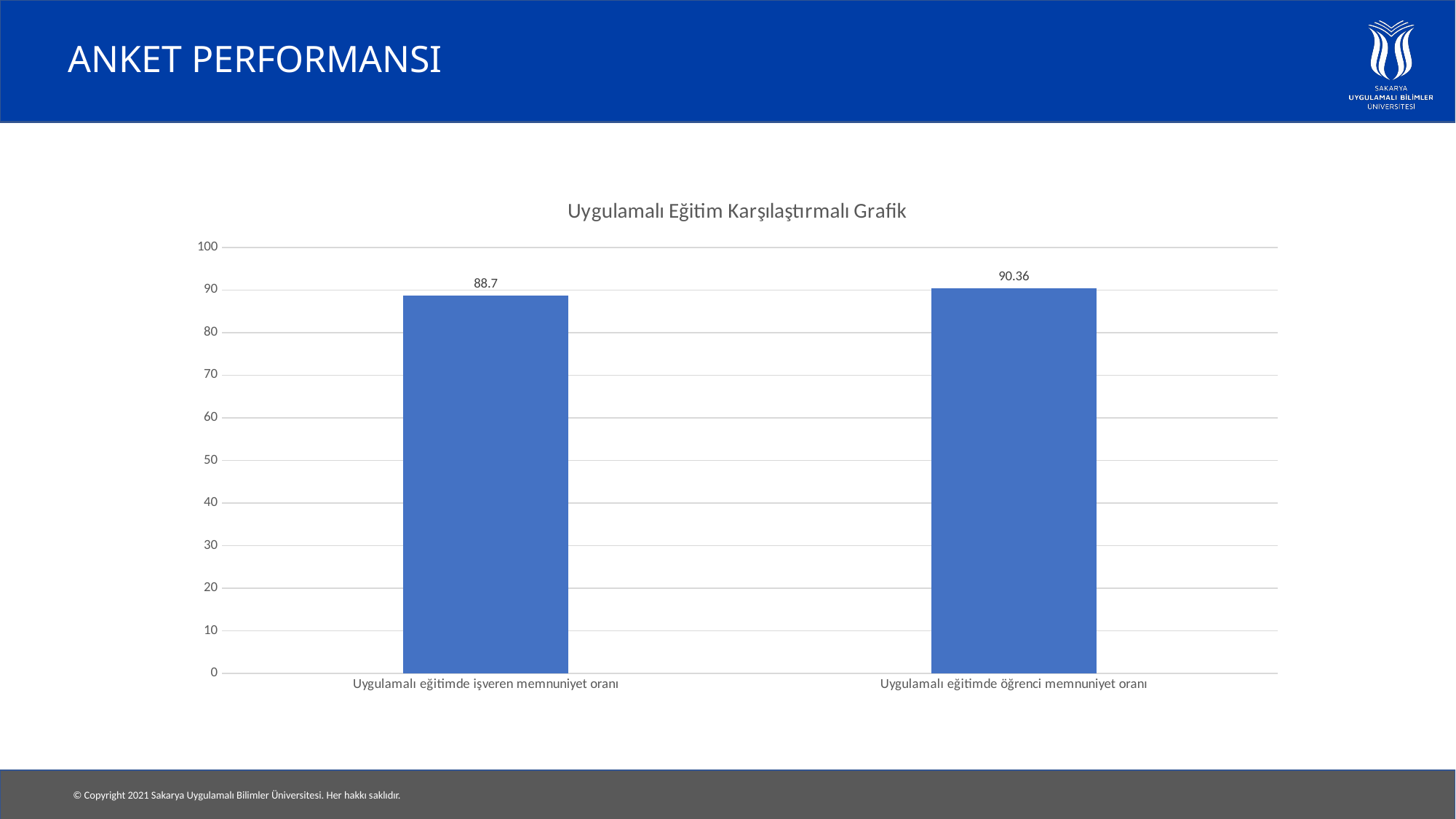
What is the title of the chart? Uygulamalı Eğitim Karşılaştırmalı Grafik Is the value for "Uygulamalı eğitimde işveren memnuniyet oranı" greater or less than 90? less Is the value for "Uygulamalı eğitimde öğrenci memnuniyet oranı" greater or less than 90? greater What is the maximum value shown on the vertical axis? 100 Which category has the lowest value? Uygulamalı eğitimde işveren memnuniyet oranı What is the value for "Uygulamalı eğitimde işveren memnuniyet oranı"? 88.7 What kind of chart is shown on the slide? bar chart Which category has the highest value? Uygulamalı eğitimde öğrenci memnuniyet oranı Which is larger: the value for "Uygulamalı eğitimde işveren memnuniyet oranı" or the value for "Uygulamalı eğitimde öğrenci memnuniyet oranı"? Uygulamalı eğitimde öğrenci memnuniyet oranı What is the value for "Uygulamalı eğitimde öğrenci memnuniyet oranı"? 90.36 How many categories are shown in the chart? 2 What is the difference between the value for "Uygulamalı eğitimde öğrenci memnuniyet oranı" and the value for "Uygulamalı eğitimde işveren memnuniyet oranı"? 1.66